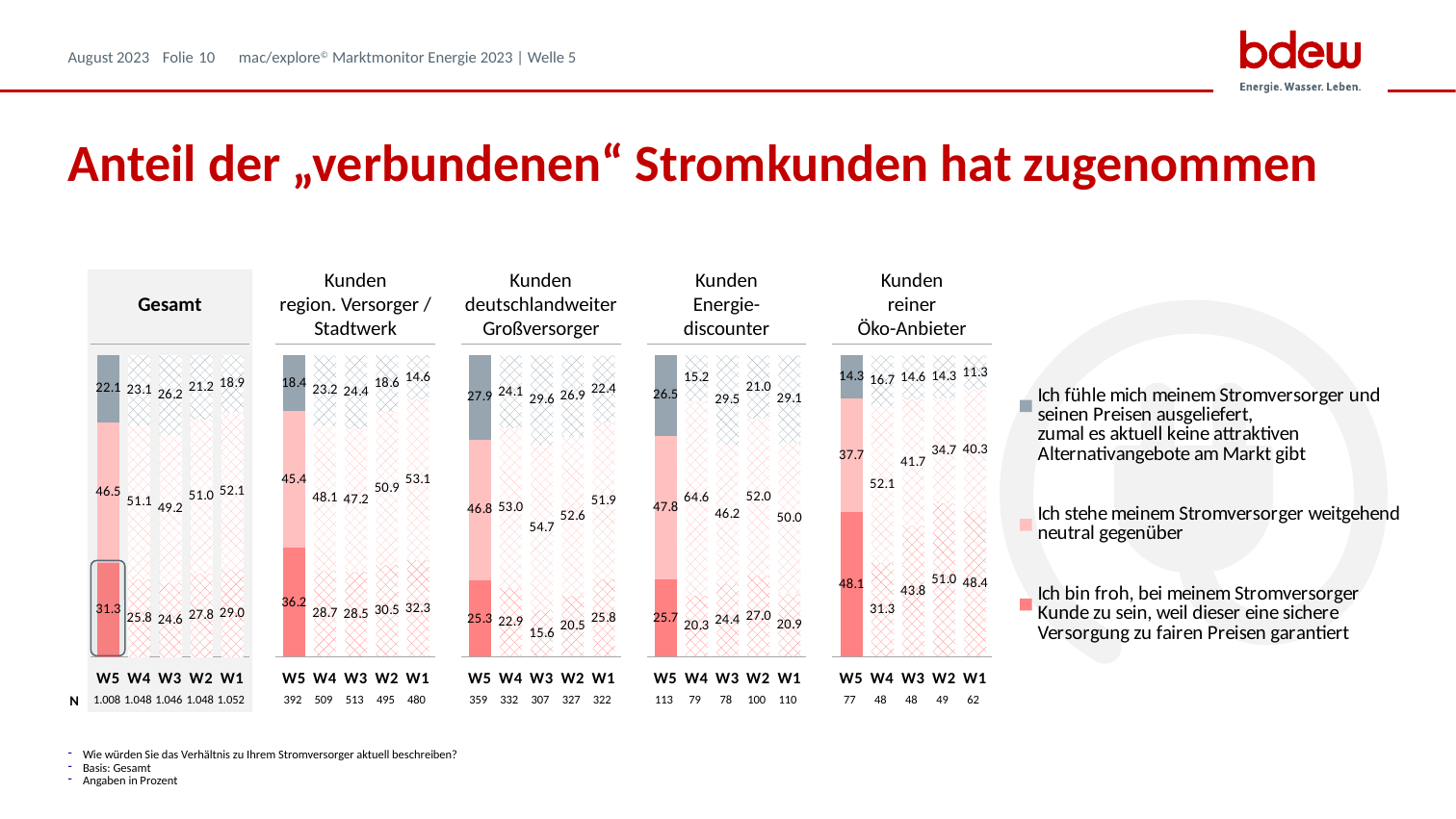
In the "Kunden region. Versorger / Stadtwerk" chart, what is the value for "Ich fühle mich meinem Stromversorger und seinen Preisen ausgeliefert" in W3? 24.4 What kind of chart is used on this slide? stacked bar chart In the "Gesamt" chart, what is the value for "Ich stehe meinem Stromversorger weitgehend neutral gegenüber" in W1? 52.1 How many waves (bars) are shown in each chart? 5 In the "Kunden reiner Öko-Anbieter" chart, what is the difference between the W5 and W4 values for "Ich bin froh, bei meinem Stromversorger Kunde zu sein"? 16.8 In the "Gesamt" chart, is the W5 value for "Ich bin froh, bei meinem Stromversorger Kunde zu sein" larger or smaller than the W4 value? larger In the "Kunden Energie-discounter" chart, what is the value for "Ich fühle mich meinem Stromversorger und seinen Preisen ausgeliefert" in W4? 15.2 In the "Kunden region. Versorger / Stadtwerk" chart, what is the N (base) for W5? 392 How many series does the legend list? 3 In the "Gesamt" chart, what is the value for "Ich bin froh, bei meinem Stromversorger Kunde zu sein" in W5? 31.3 In the "Kunden deutschlandweiter Großversorger" chart, which wave has the lowest value for "Ich bin froh, bei meinem Stromversorger Kunde zu sein"? W3 In the "Kunden Energie-discounter" chart, which wave has the highest value for "Ich stehe meinem Stromversorger weitgehend neutral gegenüber"? W4